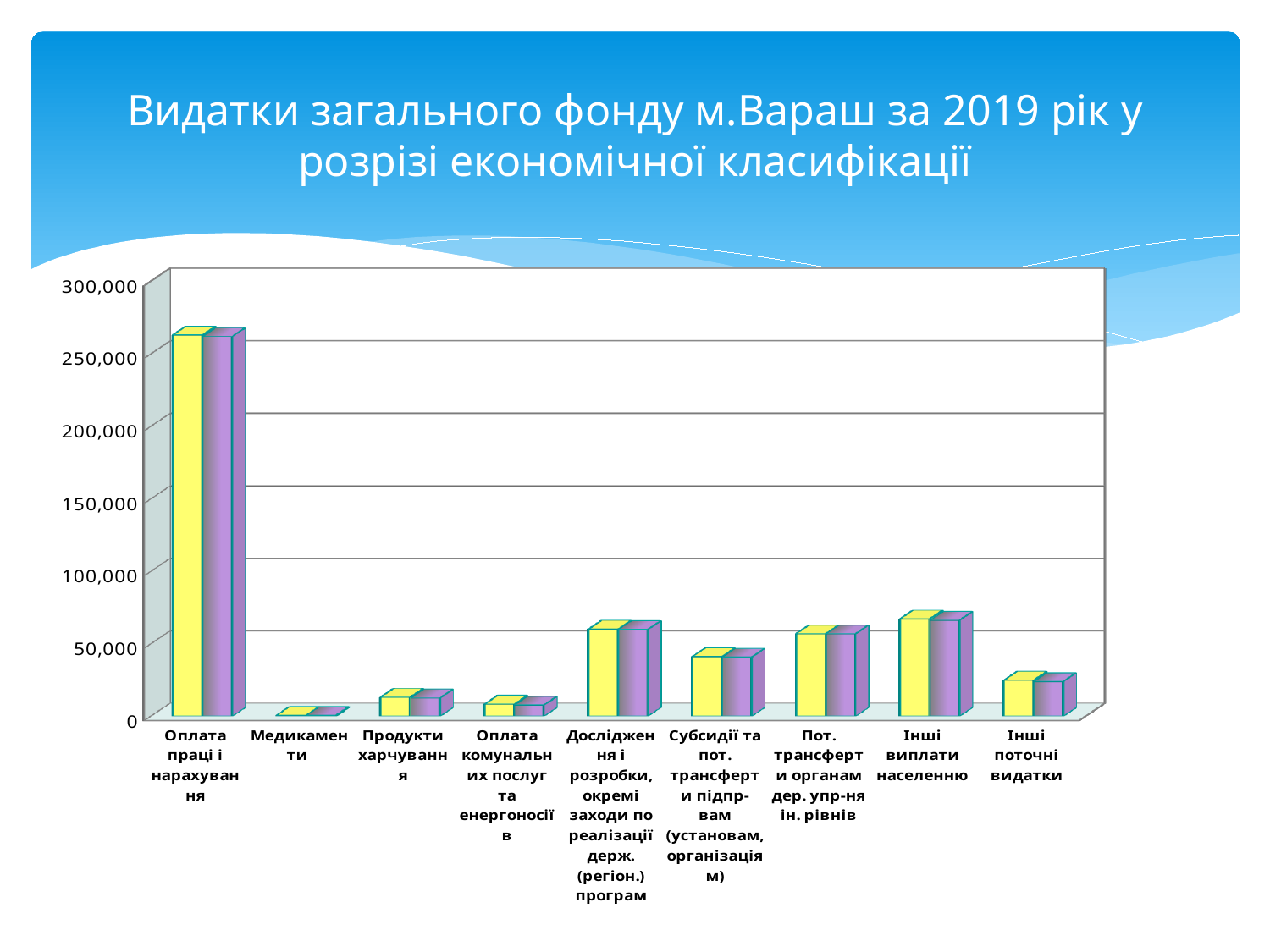
Which is larger: the value for Продукти харчування or the value for Оплата комунальних послуг та енергоносіїв? Продукти харчування Is the value for Інші поточні видатки greater or less than 50,000? less What is the highest value shown on the vertical axis of the chart? 300,000 Is the value for Оплата праці і нарахування greater or less than 250,000? greater Which category has the highest value in the chart? Оплата праці і нарахування How many categories are shown on the x axis of the chart? 9 Is the value for Інші виплати населенню greater or less than 50,000? greater Which category has the lowest value in the chart? Медикаменти What kind of chart is shown on the slide? bar chart What is the title of the slide containing the chart? Видатки загального фонду м.Вараш за 2019 рік у розрізі економічної класифікації Which is larger: the value for Інші виплати населенню or the value for Субсидії та пот. трансферти підпр-вам (установам, організаціям)? Інші виплати населенню